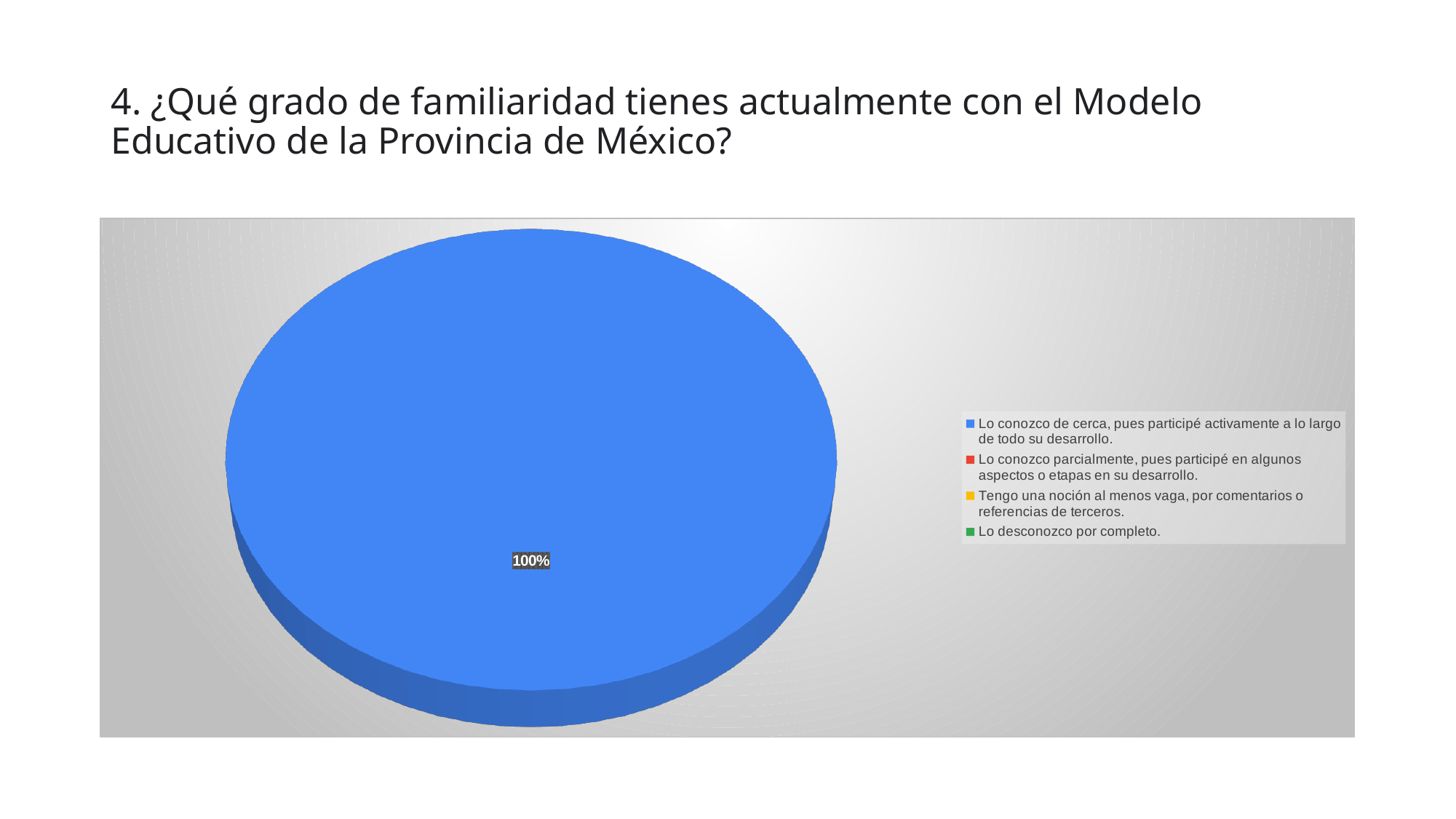
What colour is the slice that makes up the whole pie? Blue What percentage is shown on the data label of the pie chart? 100% How many slices are visible in the pie chart? 1 What kind of chart is shown on the slide? Pie chart Which category accounts for the entire pie? Lo conozco de cerca, pues participé activamente a lo largo de todo su desarrollo. How many entries does the legend of the pie chart list? 4 What share of the pie does 'Lo conozco de cerca, pues participé activamente a lo largo de todo su desarrollo.' represent? 100% Which legend entry is represented by the green colour? Lo desconozco por completo.